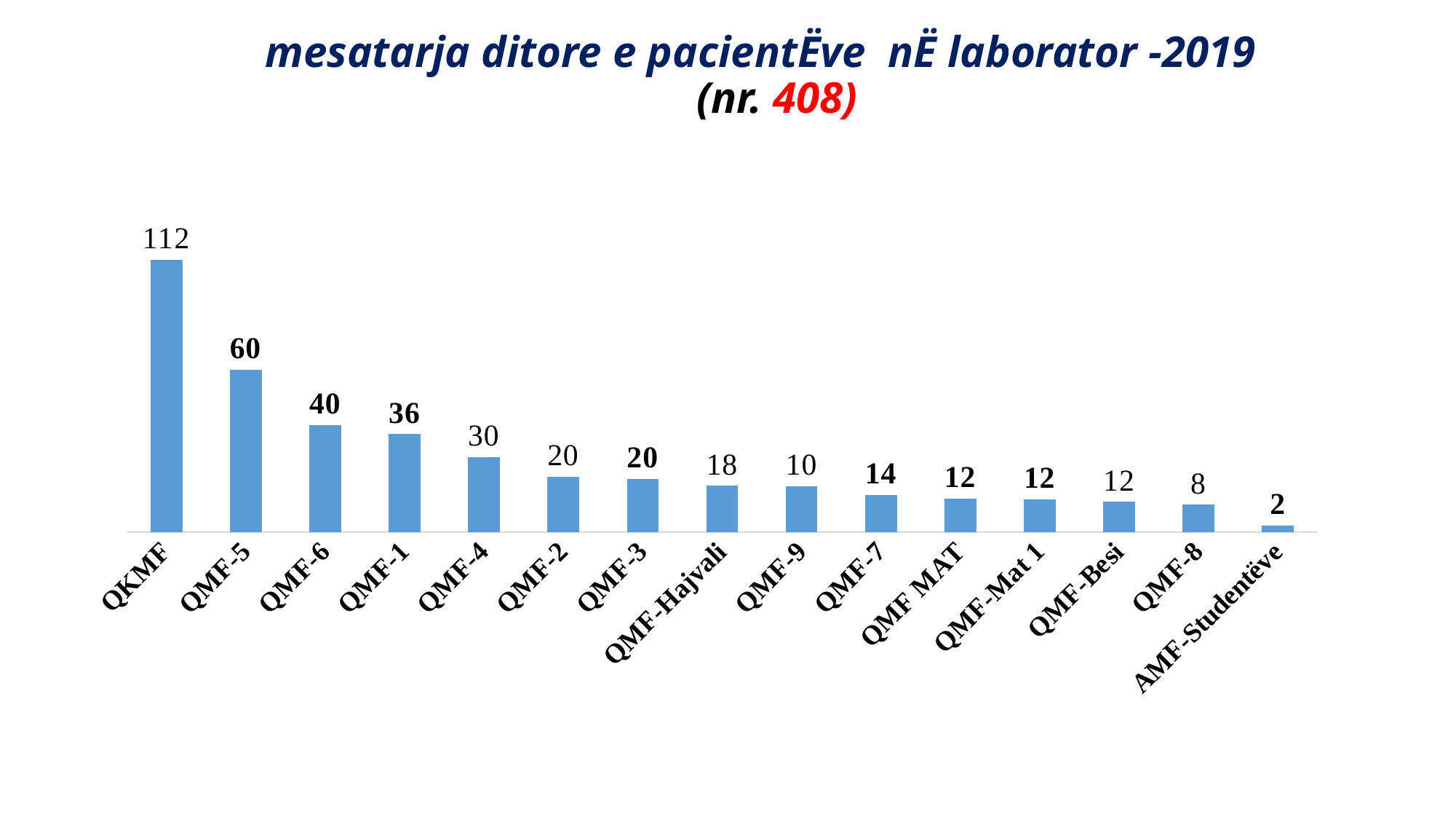
Which is larger, the value for QMF-7 or the value for QMF-9? QMF-7 What is the value for QMF-9? 10 Do the values generally rise or fall from left to right along the x axis? Fall What kind of chart is this? Bar chart What is the difference between the values for QMF-6 and QMF-1? 4 What is the value for QKMF? 112 Which category has the lowest value? AMF-Studentëve Which category has the highest value? QKMF What is the value for QMF-Hajvali? 18 What number is shown in red in the chart title? 408 How many categories are shown on the x axis? 15 What is the difference between the values for QKMF and QMF-5? 52